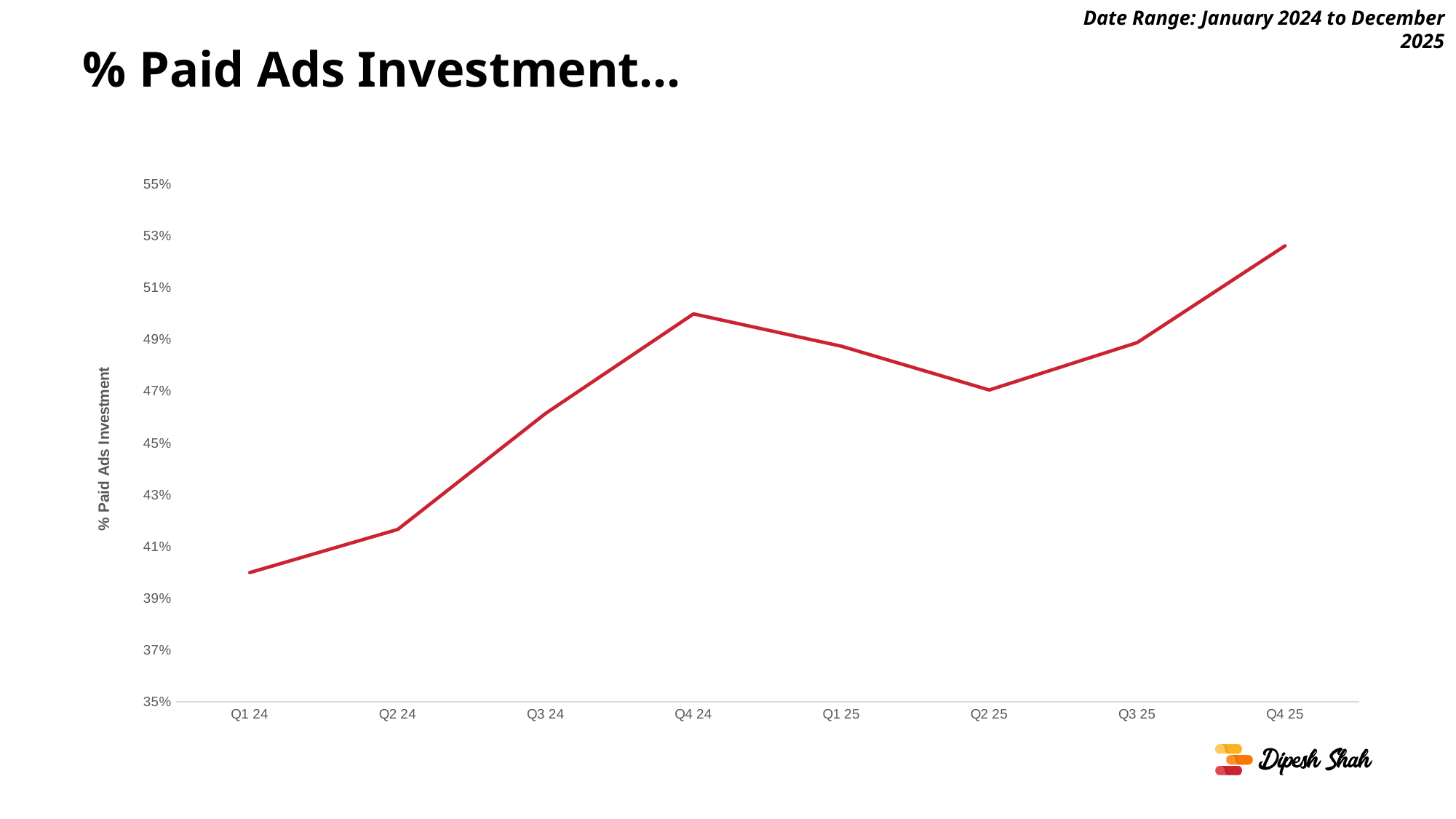
Which quarter has the lowest % Paid Ads Investment? Q1 24 Is the value for Q4 24 greater or less than 49%? greater Is the value for Q3 24 greater or less than 47%? less Which is larger, the value for Q3 24 or the value for Q1 25? Q1 25 How many quarters are plotted along the x axis? 8 What kind of chart is shown on the slide? line chart Which quarter has the highest % Paid Ads Investment? Q4 25 Do the values rise or fall from Q1 24 to Q4 24? rise What is the label on the y axis of the chart? % Paid Ads Investment Is the value for Q4 25 greater or less than 51%? greater Which is larger, the value for Q4 24 or the value for Q2 25? Q4 24